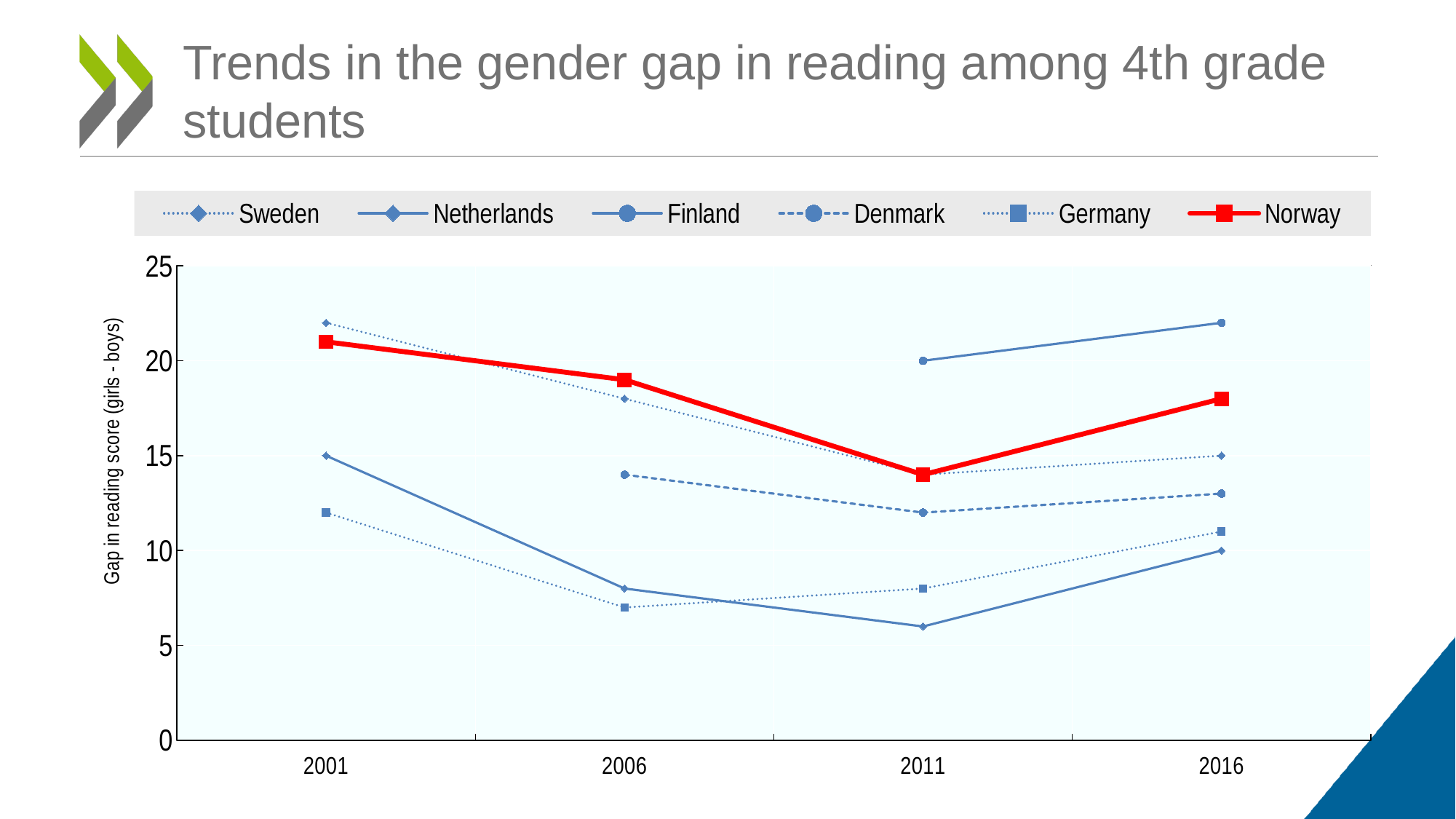
Does the value for Netherlands rise or fall from 2001 to 2011? fall Which country has the highest value in 2016? Finland Which country has the lowest value in 2011? Netherlands What kind of chart is shown on the slide? line chart What is the value for Netherlands in 2016? 10 Is the value for Norway in 2001 greater or less than 20? greater What is the value for Finland in 2011? 20 How many years are shown on the x axis? 4 How many series does the legend list? 6 Which series is drawn in red? Norway What is the value for Netherlands in 2001? 15 Is the value for Germany in 2006 greater or less than 10? less